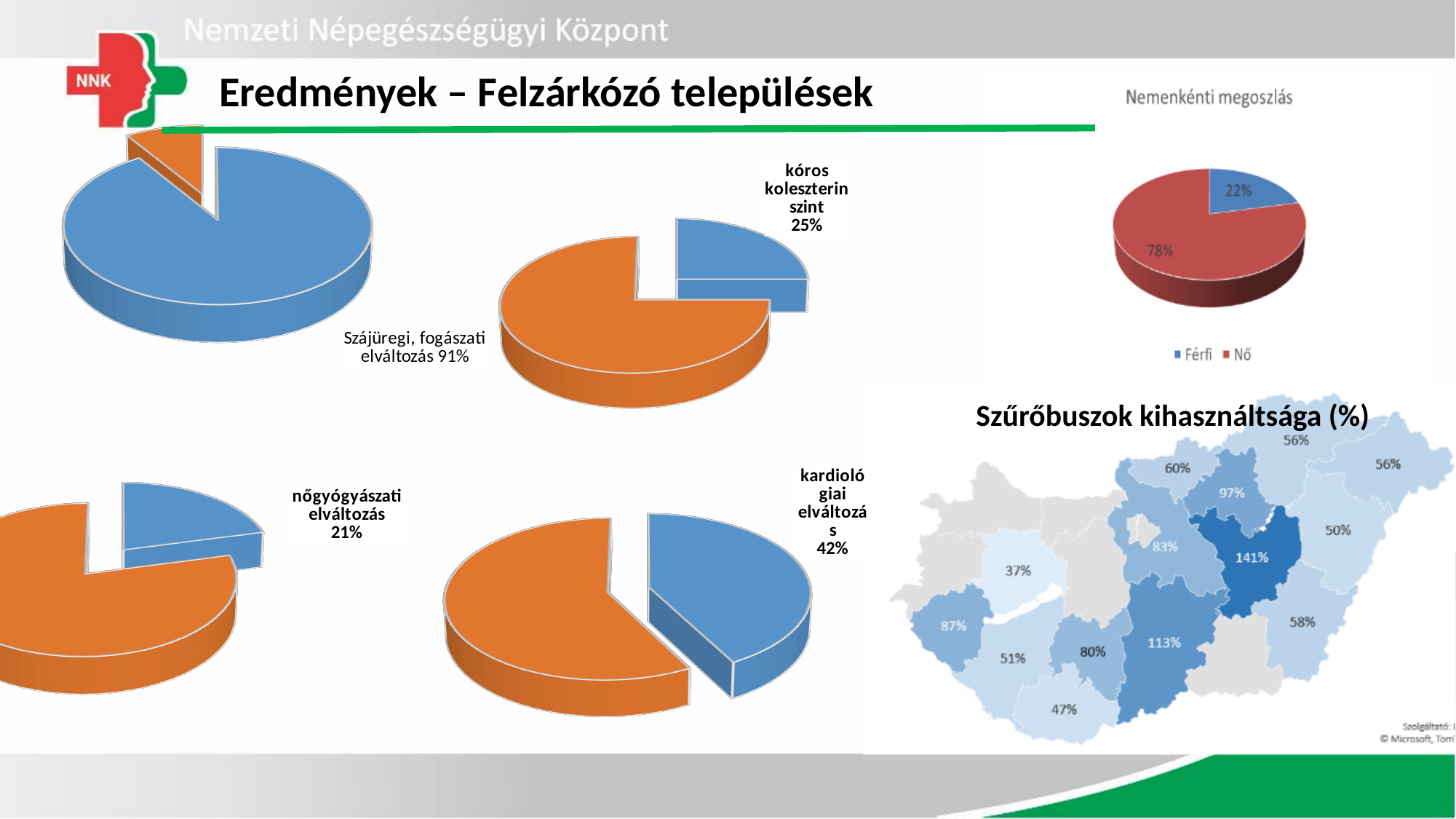
On the 'Szűrőbuszok kihasználtsága (%)' map, what is the highest percentage shown? 141% On the 'Szűrőbuszok kihasználtsága (%)' map, what is the lowest percentage shown? 37% In the pie chart labelled 'nőgyógyászati elváltozás', what percentage is shown? 21% What kind of chart is the 'Nemenkénti megoszlás' chart? pie chart How many entries does the legend of the 'Nemenkénti megoszlás' chart list? 2 In the 'Nemenkénti megoszlás' pie chart, what share is labelled for Nő? 78% In the 'Nemenkénti megoszlás' pie chart, which category has the larger share, Férfi or Nő? Nő In the 'Nemenkénti megoszlás' pie chart, what share is labelled for Férfi? 22% In the 'Nemenkénti megoszlás' pie chart, what is the difference between the Nő share and the Férfi share? 56% In the pie chart labelled 'kóros koleszterin szint', what percentage is shown? 25% In the pie chart labelled 'Szájüregi, fogászati elváltozás' at the top left, what percentage is shown? 91% In the pie chart labelled 'kardiológiai elváltozás', what percentage is shown? 42%